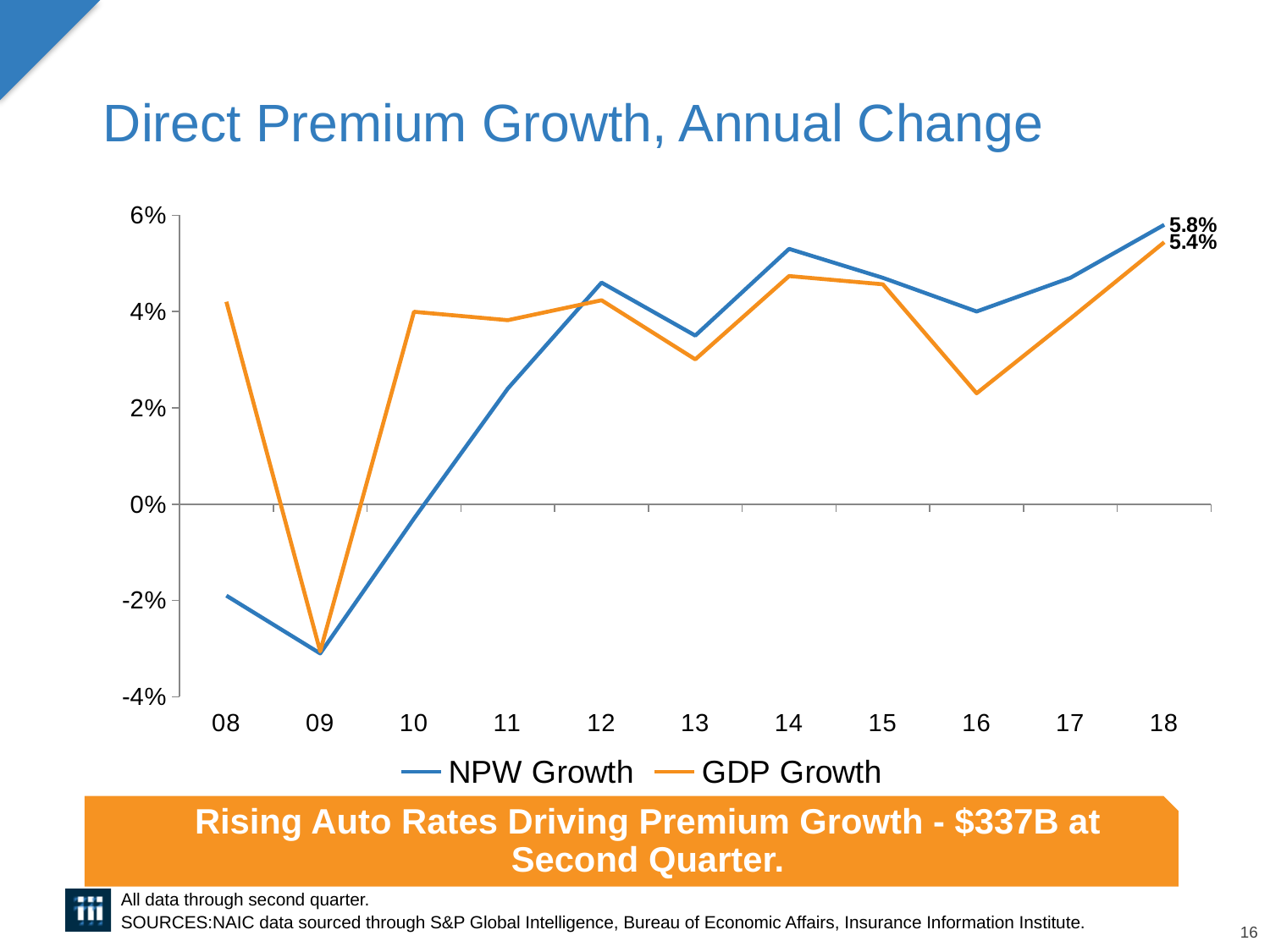
How many series does the legend list? 2 In 16, which series has the higher value, NPW Growth or GDP Growth? NPW Growth What type of chart is shown on the slide? Line chart In which year is NPW Growth at its lowest? 09 How many years are shown on the x axis? 11 In 08, which series has the higher value, NPW Growth or GDP Growth? GDP Growth Is the NPW Growth value for 08 greater or less than 0%? less What is the NPW Growth value for 18? 5.8% Is the NPW Growth value for 14 greater or less than 4%? greater What is the difference between NPW Growth and GDP Growth in 18? 0.4% In which year is GDP Growth at its highest? 18 What is the GDP Growth value for 18? 5.4%